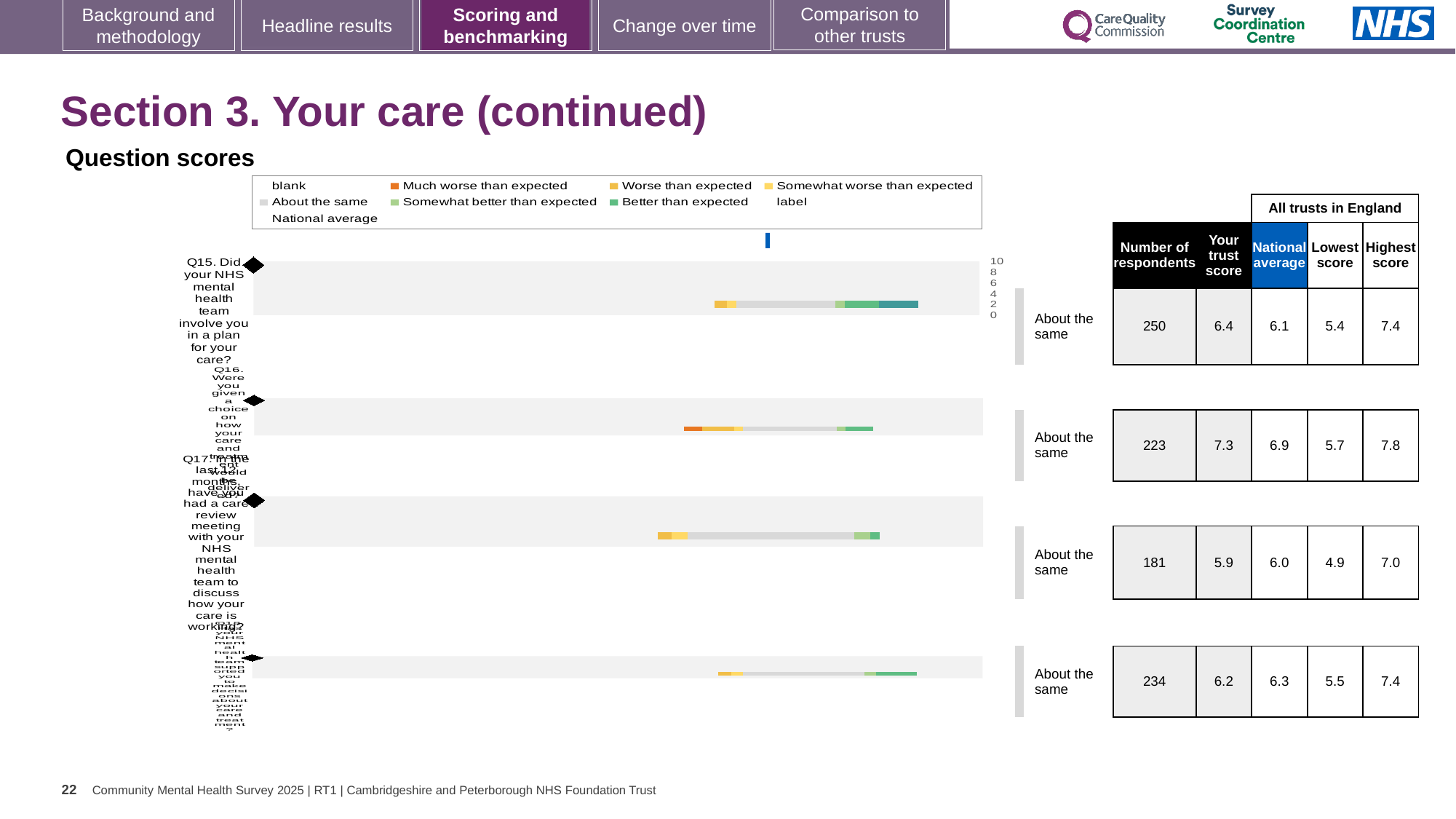
What is the highest score among all trusts in England for Q16? 7.8 What is the difference between the highest score and the lowest score for Q15? 2.0 How many respondents answered Q17 (care review meeting in the last 12 months)? 181 Which question has the highest 'Your trust score'? Q16 By how much does the trust score for Q16 exceed the national average for Q16? 0.4 How many question rows (bars) are plotted in the chart? 4 What is the 'Your trust score' for Q15 (Did your NHS mental health team involve you in a plan for your care?)? 6.4 For Q17, which is larger: the trust score or the national average? National average What benchmark label is shown next to the Q15 bar? About the same What is the national average score for Q16 (Were you given a choice on how your care and treatment would be delivered?)? 6.9 What kind of chart is shown under 'Question scores'? bar chart Which question has the lowest 'Your trust score'? Q17